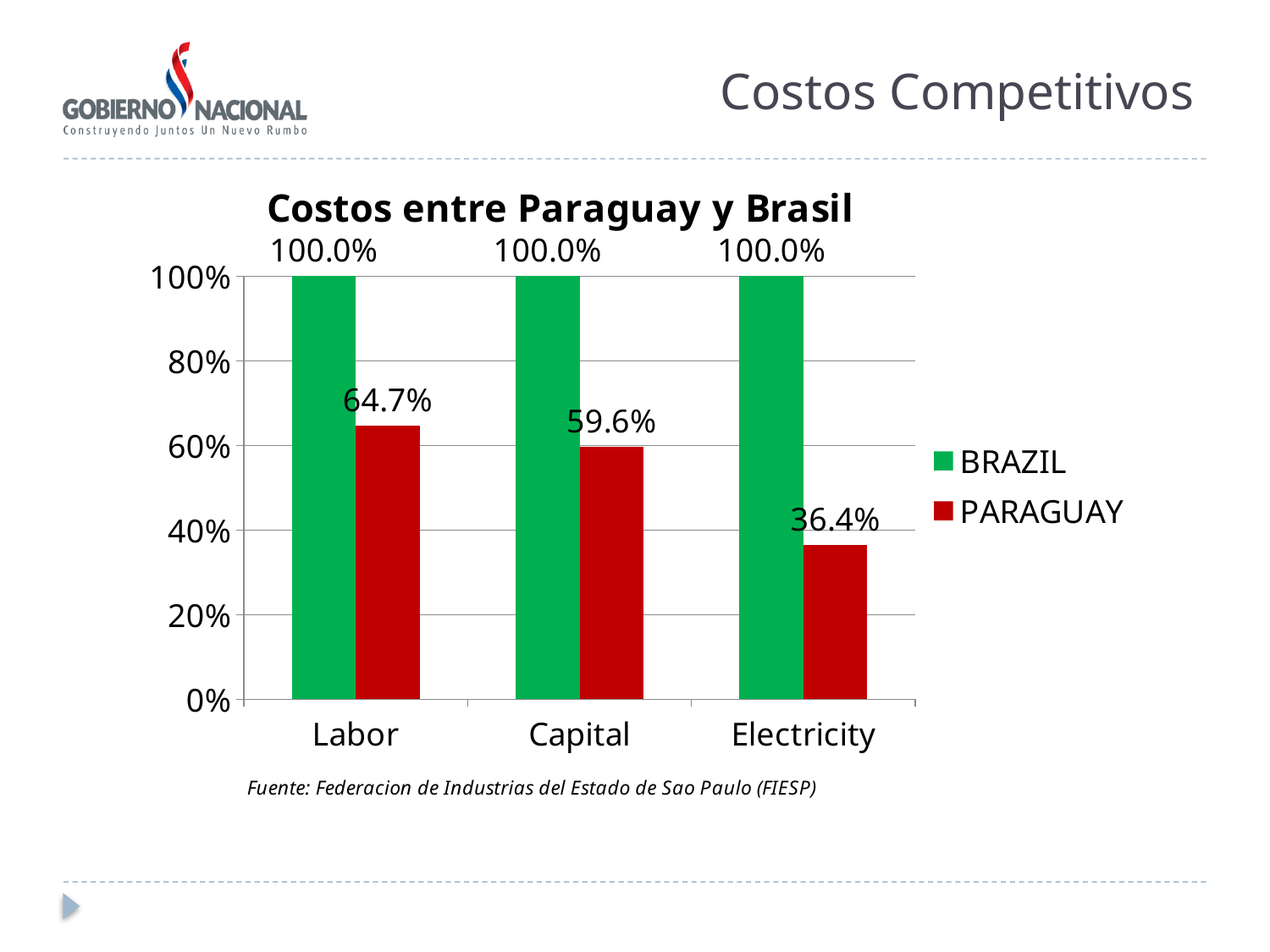
What is the value for PARAGUAY in the Capital category? 59.6% What is the value for PARAGUAY in the Labor category? 64.7% Which is larger, the PARAGUAY value for Capital or for Electricity? Capital What is the title of the chart? Costos entre Paraguay y Brasil What is the difference between the PARAGUAY values for Labor and Capital? 5.1% In which category is the PARAGUAY value lowest? Electricity How many categories are shown on the x axis? 3 In which category is the PARAGUAY value highest? Labor What is the difference between the BRAZIL and PARAGUAY values for Electricity? 63.6% What is the value for PARAGUAY in the Electricity category? 36.4% How many series does the legend list? 2 What is the value for BRAZIL in the Electricity category? 100.0%